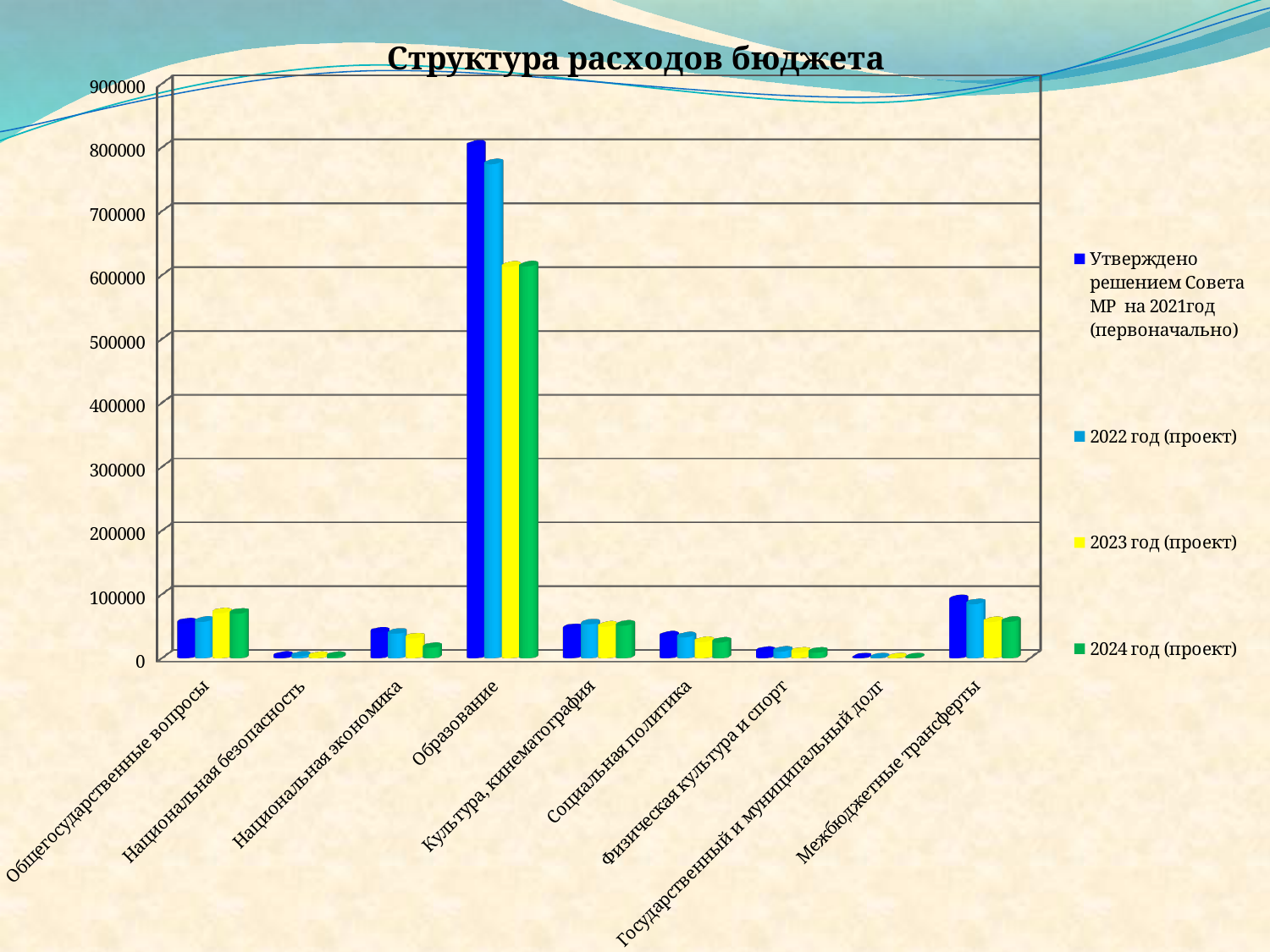
Which category has the lowest values in the chart? Государственный и муниципальный долг What is the title of the chart? Структура расходов бюджета Do the values for Образование rise or fall from the 2021 series to the 2024 series? fall What kind of chart is shown on the slide? Bar chart Is the value for Образование in the series 'Утверждено решением Совета МР на 2021год (первоначально)' greater or less than 700000? greater For the series '2022 год (проект)', which is larger: Образование or Межбюджетные трансферты? Образование Which category has the highest values in the chart? Образование Is the value for Образование in the series '2022 год (проект)' greater or less than 800000? less How many categories are shown on the x axis of the chart? 9 For the series '2023 год (проект)', which is larger: Общегосударственные вопросы or Национальная экономика? Общегосударственные вопросы How many series does the legend list? 4